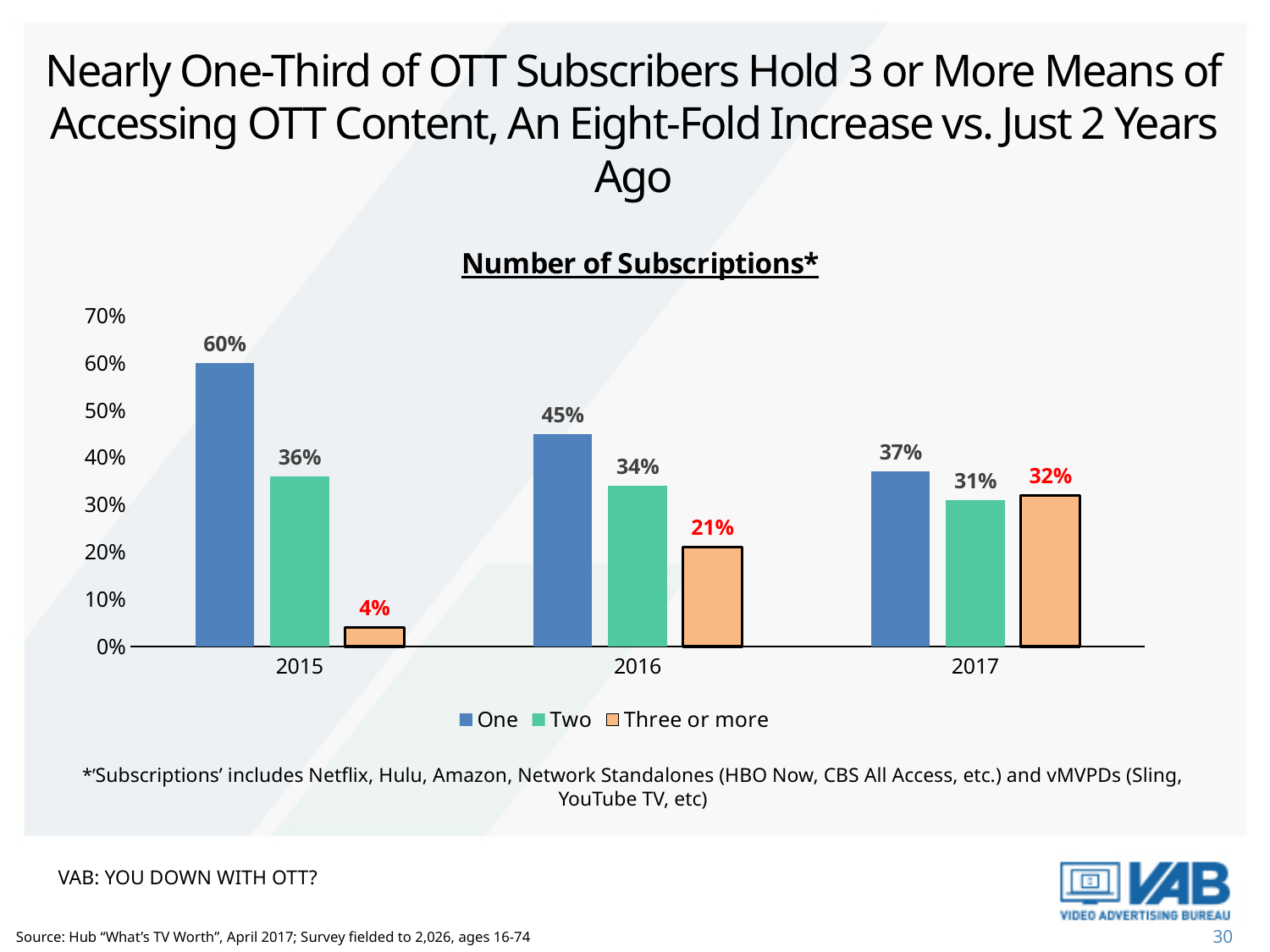
Which is larger in 2017: the value for 'Two' or the value for 'Three or more'? Three or more Does the value for 'Three or more' subscriptions rise or fall from 2015 to 2017? Rise What is the value for 'One' subscription in 2015? 60% What is the difference between the 'One' value in 2015 and the 'One' value in 2017? 23% Which year has the lowest value for 'One' subscription? 2017 Is the value for 'Three or more' in 2016 greater or less than 30%? less How many series does the legend list? 3 What is the value for 'Two' subscriptions in 2016? 34% How many years are shown on the x axis? 3 What is the value for 'Three or more' subscriptions in 2017? 32% Which year has the highest value for 'Three or more' subscriptions? 2017 What kind of chart is shown on the slide? Bar chart